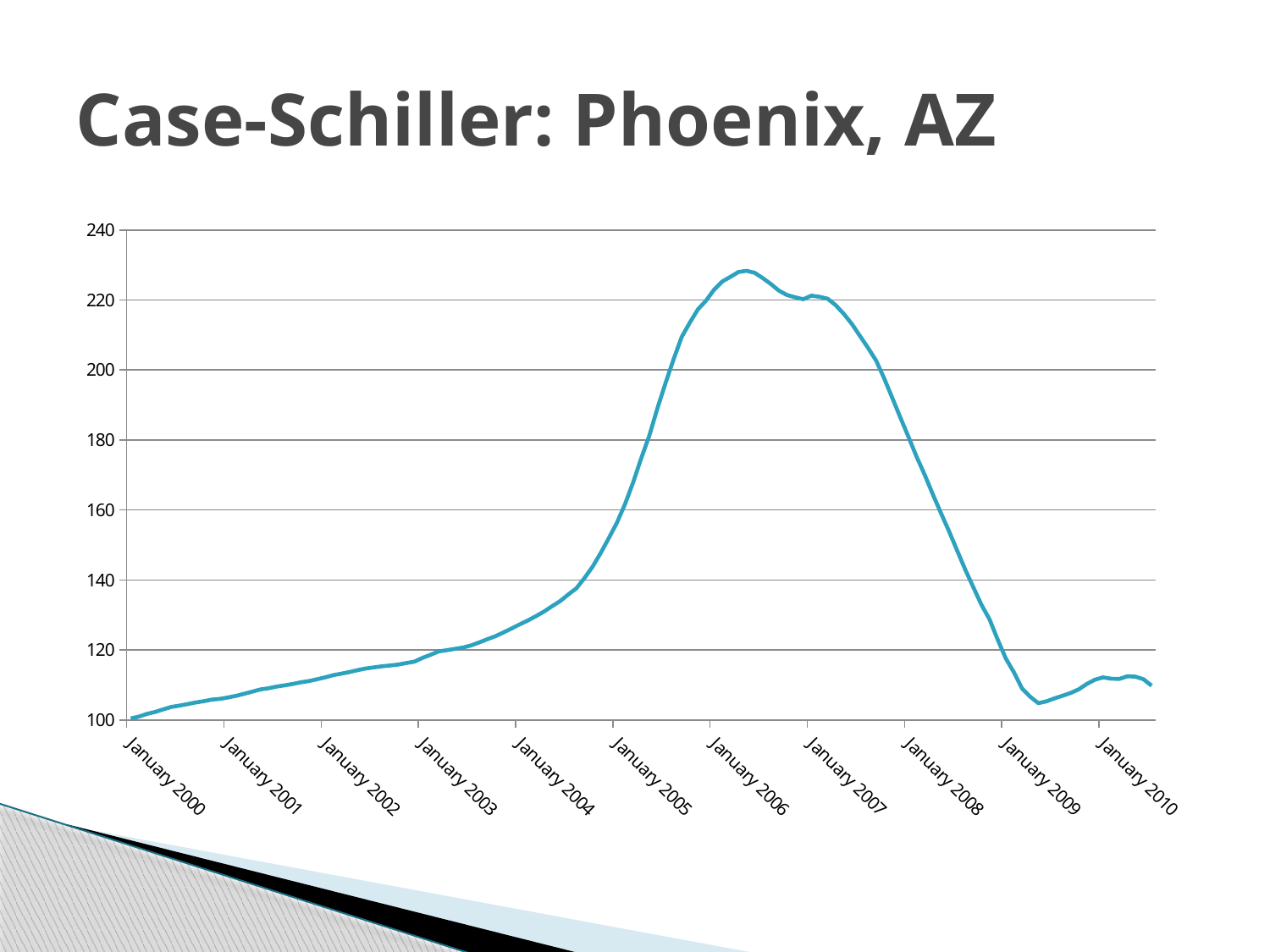
At which x-axis label is the line at its lowest value? January 2000 Is the value at January 2008 greater or less than 160? greater What is the title of the slide's chart? Case-Schiller: Phoenix, AZ What kind of chart is shown on the slide? line chart Is the value at January 2002 greater or less than 120? less Is the value at January 2006 greater or less than 220? greater Around which year does the line reach its highest point? 2006 Does the line rise or fall between January 2000 and January 2006? rise How many January tick labels are shown on the x axis? 11 Does the line rise or fall between January 2007 and January 2009? fall